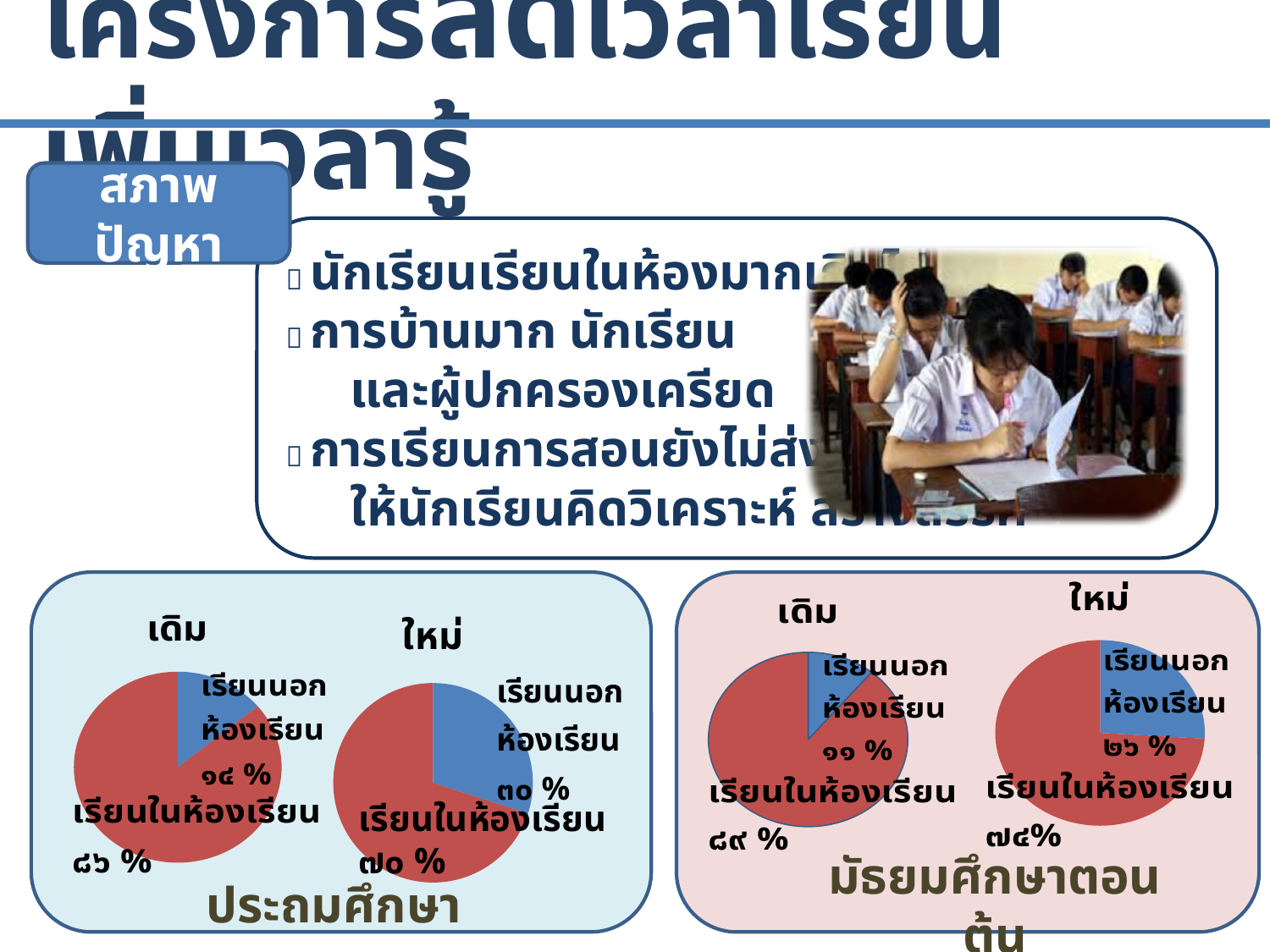
How many pie charts are shown on the slide in total? 4 In the 'มัธยมศึกษาตอนต้น' box, what share of the 'เดิม' pie is 'เรียนในห้องเรียน'? ๘๙ % In the 'ประถมศึกษา' box, what share of the 'ใหม่' pie is 'เรียนในห้องเรียน'? ๗๐ % In the 'ประถมศึกษา' box, what share of the 'เดิม' pie is 'เรียนในห้องเรียน'? ๘๖ % In the 'มัธยมศึกษาตอนต้น' box, what share of the 'ใหม่' pie is 'เรียนนอกห้องเรียน'? ๒๖ % What kind of chart is used in the 'ประถมศึกษา' and 'มัธยมศึกษาตอนต้น' boxes? Pie chart How many slices does each pie chart on the slide have? 2 In the 'ประถมศึกษา' 'ใหม่' pie, which slice is larger: 'เรียนในห้องเรียน' or 'เรียนนอกห้องเรียน'? เรียนในห้องเรียน In the 'ประถมศึกษา' box, what share of the 'ใหม่' pie is 'เรียนนอกห้องเรียน'? ๓๐ % In the 'มัธยมศึกษาตอนต้น' box, what share of the 'ใหม่' pie is 'เรียนในห้องเรียน'? ๗๔% In the 'ประถมศึกษา' box, what share of the 'เดิม' pie is 'เรียนนอกห้องเรียน'? ๑๔ % In the 'มัธยมศึกษาตอนต้น' box, what share of the 'เดิม' pie is 'เรียนนอกห้องเรียน'? ๑๑ %